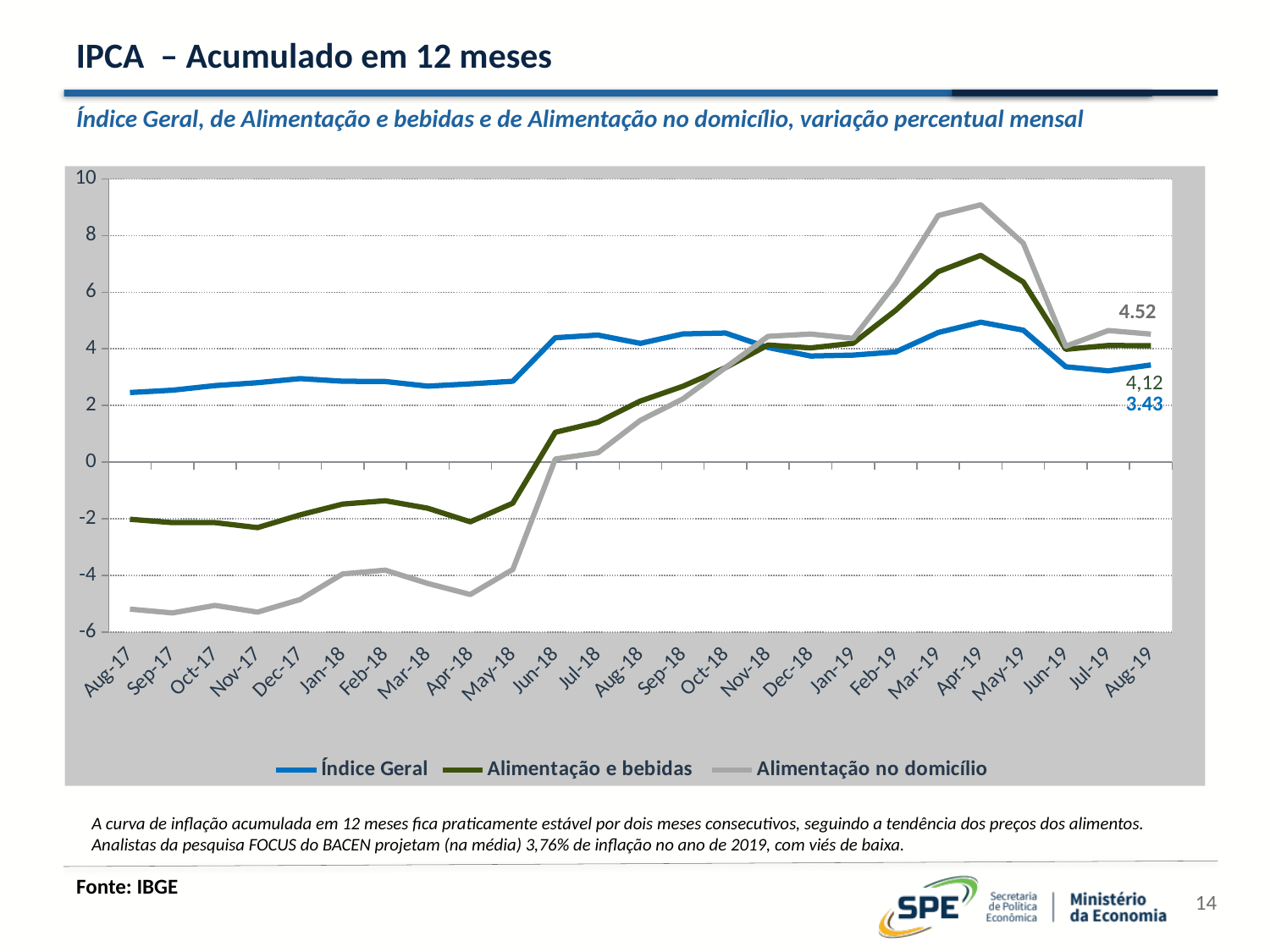
Does the Alimentação no domicílio line rise or fall from Aug-17 to Apr-19? rise What is the value of Alimentação e bebidas at Aug-19? 4,12 Is the value for Alimentação no domicílio at Aug-17 greater or less than -4? less How many series does the legend list? 3 What is the value of Índice Geral at Aug-19? 3.43 How many months are plotted along the x axis? 25 What is the difference between Alimentação no domicílio and Índice Geral at Aug-19? 1.09 Is the value for Alimentação no domicílio at Apr-19 greater or less than 8? greater What kind of chart is shown on the slide? line chart At Aug-19, which is larger: Alimentação no domicílio or Índice Geral? Alimentação no domicílio Which series has the highest value at Aug-19? Alimentação no domicílio What is the value of Alimentação no domicílio at Aug-19? 4.52